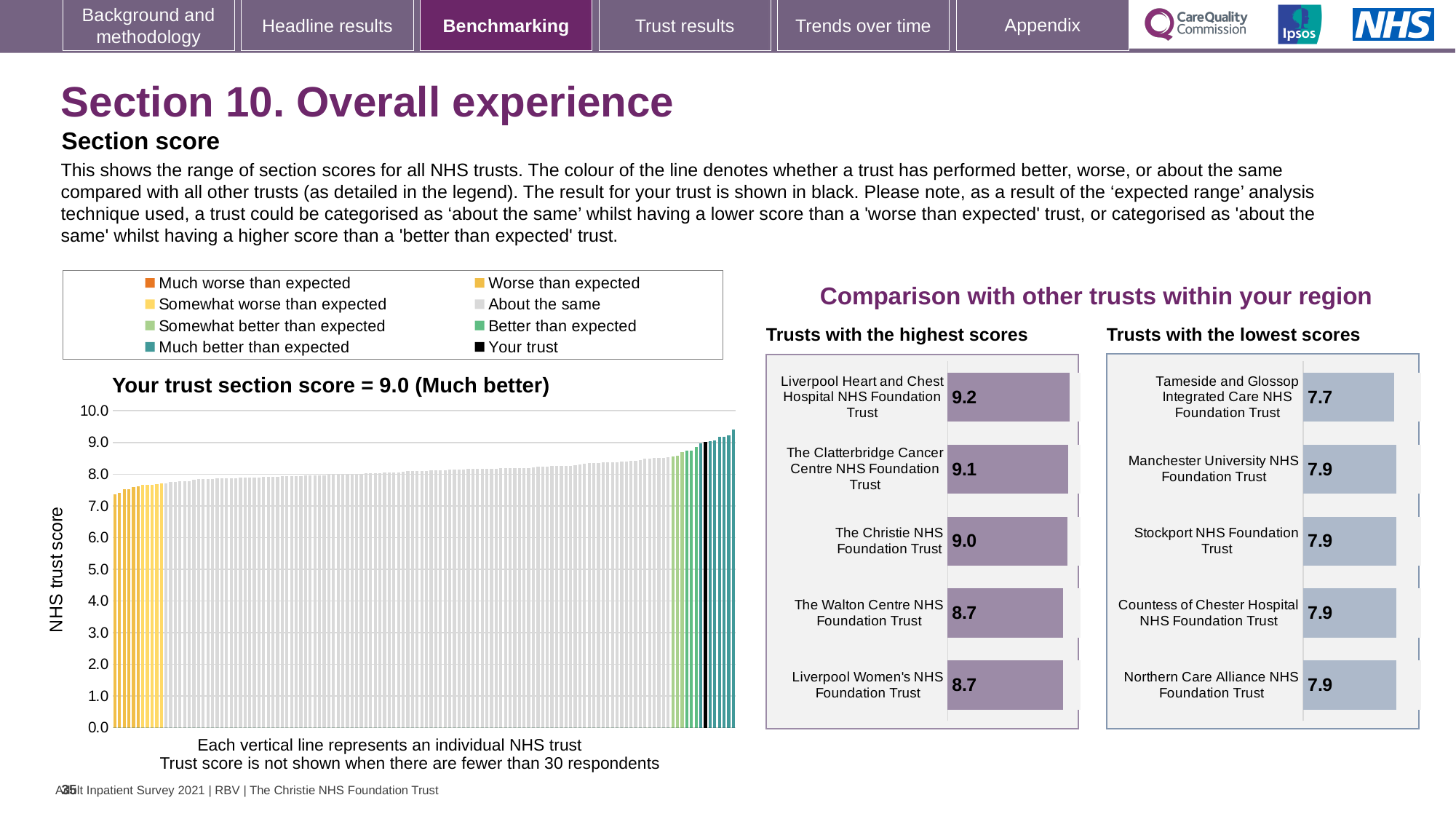
In the 'Trusts with the lowest scores' chart, which trust has the lowest score? Tameside and Glossop Integrated Care NHS Foundation Trust In the 'Trusts with the highest scores' chart, which trust has the highest score? Liverpool Heart and Chest Hospital NHS Foundation Trust How many entries does the legend above the 'Your trust section score' chart list? 8 In the 'Trusts with the highest scores' chart, what is the score for The Walton Centre NHS Foundation Trust? 8.7 Which is larger: the score for Stockport NHS Foundation Trust in the 'Trusts with the lowest scores' chart or the score for The Christie NHS Foundation Trust in the 'Trusts with the highest scores' chart? The Christie NHS Foundation Trust In the 'Trusts with the highest scores' chart, how many trusts are shown? 5 What is the y-axis label of the 'Your trust section score' chart? NHS trust score In the 'Your trust section score' chart, is the value of the leftmost (lowest) bar greater or less than 8.0? less In the 'Your trust section score' chart, do the bars rise or fall from left to right? rise In the 'Trusts with the highest scores' chart, what is the difference between the scores of Liverpool Heart and Chest Hospital NHS Foundation Trust and Liverpool Women's NHS Foundation Trust? 0.5 In the 'Your trust section score' chart, what is the section score for your trust? 9.0 What kind of chart is the 'Your trust section score' chart? bar chart